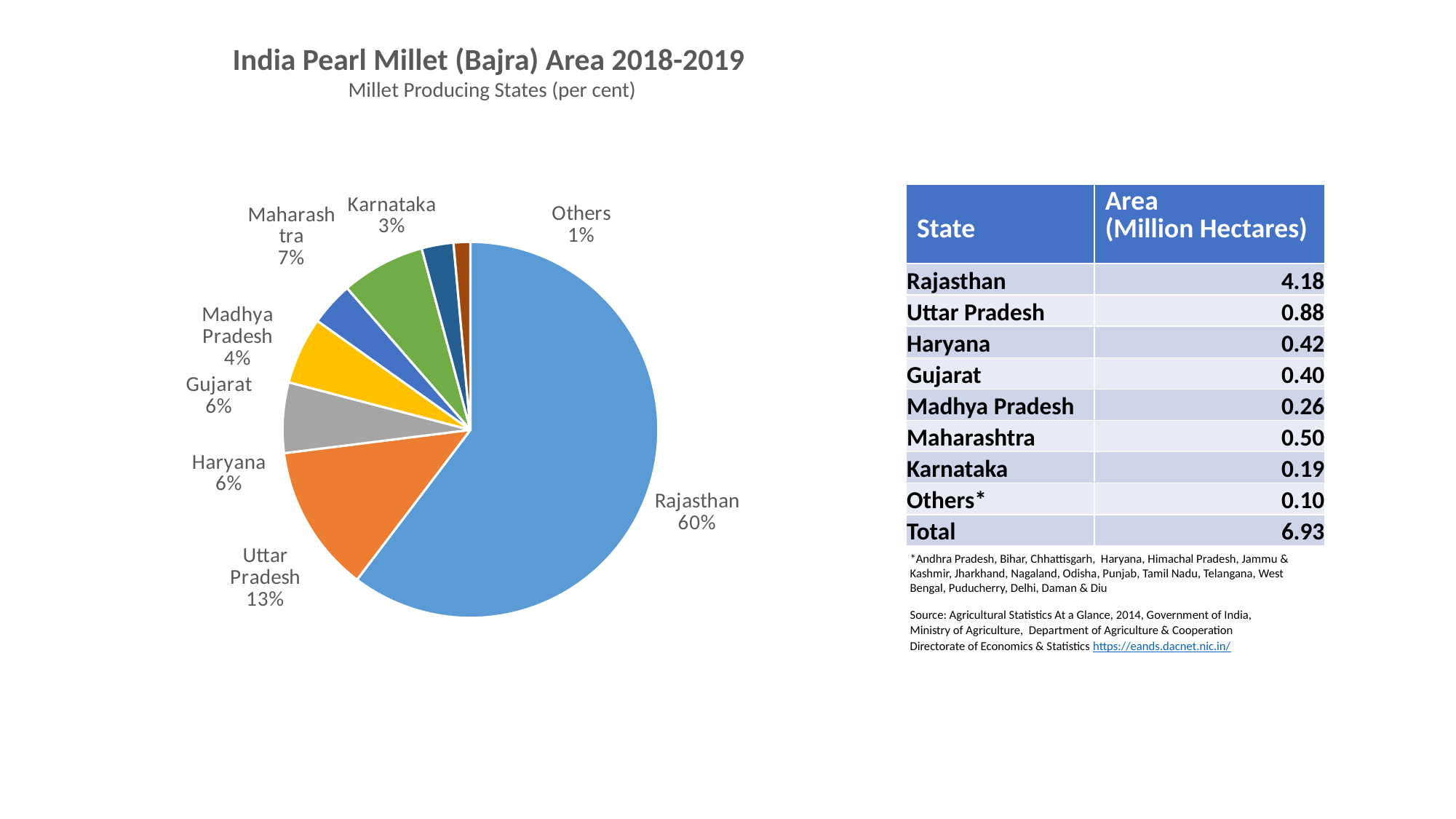
What type of chart is shown on the slide? Pie chart Which slice of the pie chart is the smallest? Others What percentage is shown for Maharashtra in the pie chart? 7% Which state has the largest slice of the pie chart? Rajasthan What percentage is shown for Uttar Pradesh in the pie chart? 13% How many slices does the pie chart have? 8 What share of the pie does Rajasthan hold? 60% What colour is the Rajasthan slice in the pie chart? Blue Which has a larger share in the pie chart, Maharashtra or Madhya Pradesh? Maharashtra What is the title of the chart? India Pearl Millet (Bajra) Area 2018-2019 What percentage is shown for Karnataka in the pie chart? 3% What is the difference in percentage points between Rajasthan and Uttar Pradesh in the pie chart? 47